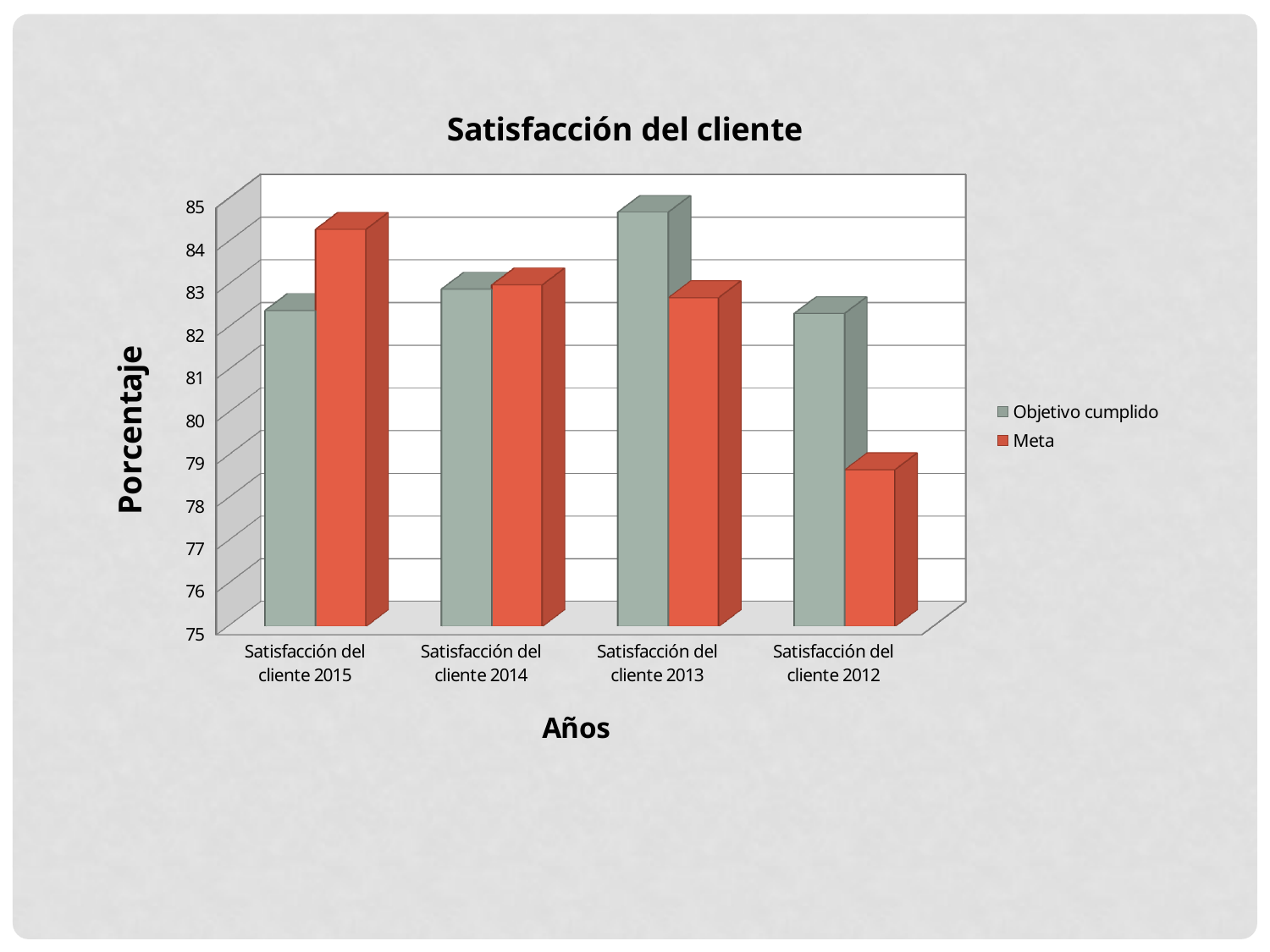
For which category is the Objetivo cumplido value highest? Satisfacción del cliente 2013 How many categories are shown on the x axis? 4 What kind of chart is shown on the slide? bar chart For Satisfacción del cliente 2015, which is larger: Objetivo cumplido or Meta? Meta How many series does the legend list? 2 For which category is the Meta value lowest? Satisfacción del cliente 2012 Is the Meta value for Satisfacción del cliente 2012 greater or less than 80? less What is the label of the vertical axis? Porcentaje Is the Objetivo cumplido value for Satisfacción del cliente 2013 greater or less than 84? greater For Satisfacción del cliente 2012, which is larger: Objetivo cumplido or Meta? Objetivo cumplido For which category is the Meta value highest? Satisfacción del cliente 2015 What is the title of the chart? Satisfacción del cliente